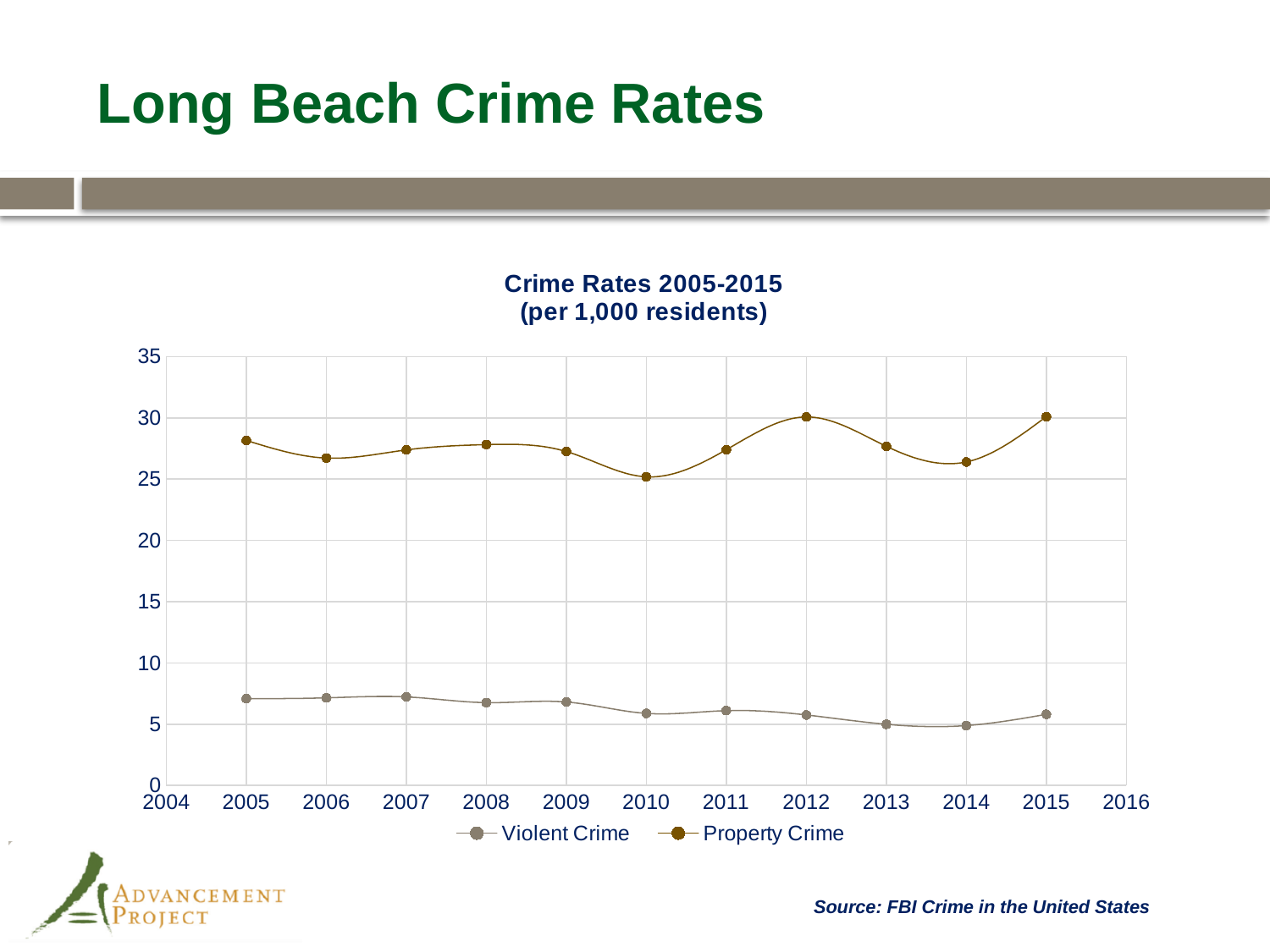
How many years of data points are plotted for each series? 11 Is the Violent Crime value for 2005 greater or less than 5? greater What kind of chart is shown on the slide? line chart What is the title of the chart? Crime Rates 2005-2015 (per 1,000 residents) Is the Property Crime value for 2010 greater or less than 30? less Does the Violent Crime rate generally rise or fall from 2005 to 2015? fall How many series does the legend list? 2 Which is larger in 2015, Violent Crime or Property Crime? Property Crime Is the Violent Crime value for 2013 greater or less than 10? less Which is larger, the Property Crime value for 2012 or for 2010? 2012 What are the two series named in the legend? Violent Crime and Property Crime